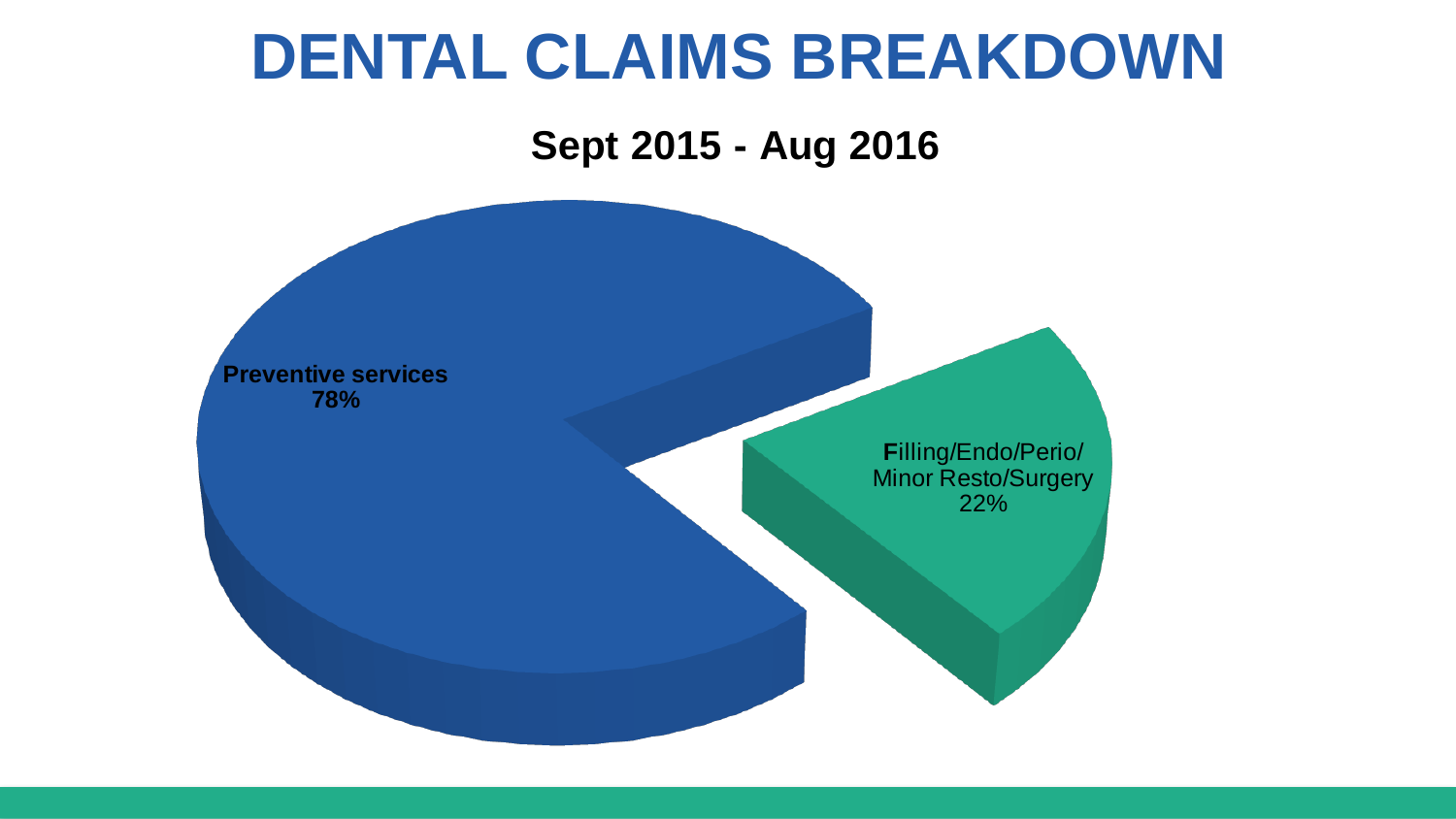
What share of dental claims is for Preventive services? 78% Which category has the largest share of dental claims? Preventive services How many slices does the pie chart have? 2 What time period does the chart cover? Sept 2015 - Aug 2016 What share of dental claims is for Filling/Endo/Perio/Minor Resto/Surgery? 22% Which is larger: the share for Preventive services or the share for Filling/Endo/Perio/Minor Resto/Surgery? Preventive services What kind of chart is shown on the slide? Pie chart Which category has the smallest share of dental claims? Filling/Endo/Perio/Minor Resto/Surgery What is the title of the chart on the slide? DENTAL CLAIMS BREAKDOWN What is the difference in percentage points between the Preventive services share and the Filling/Endo/Perio/Minor Resto/Surgery share? 56 percentage points